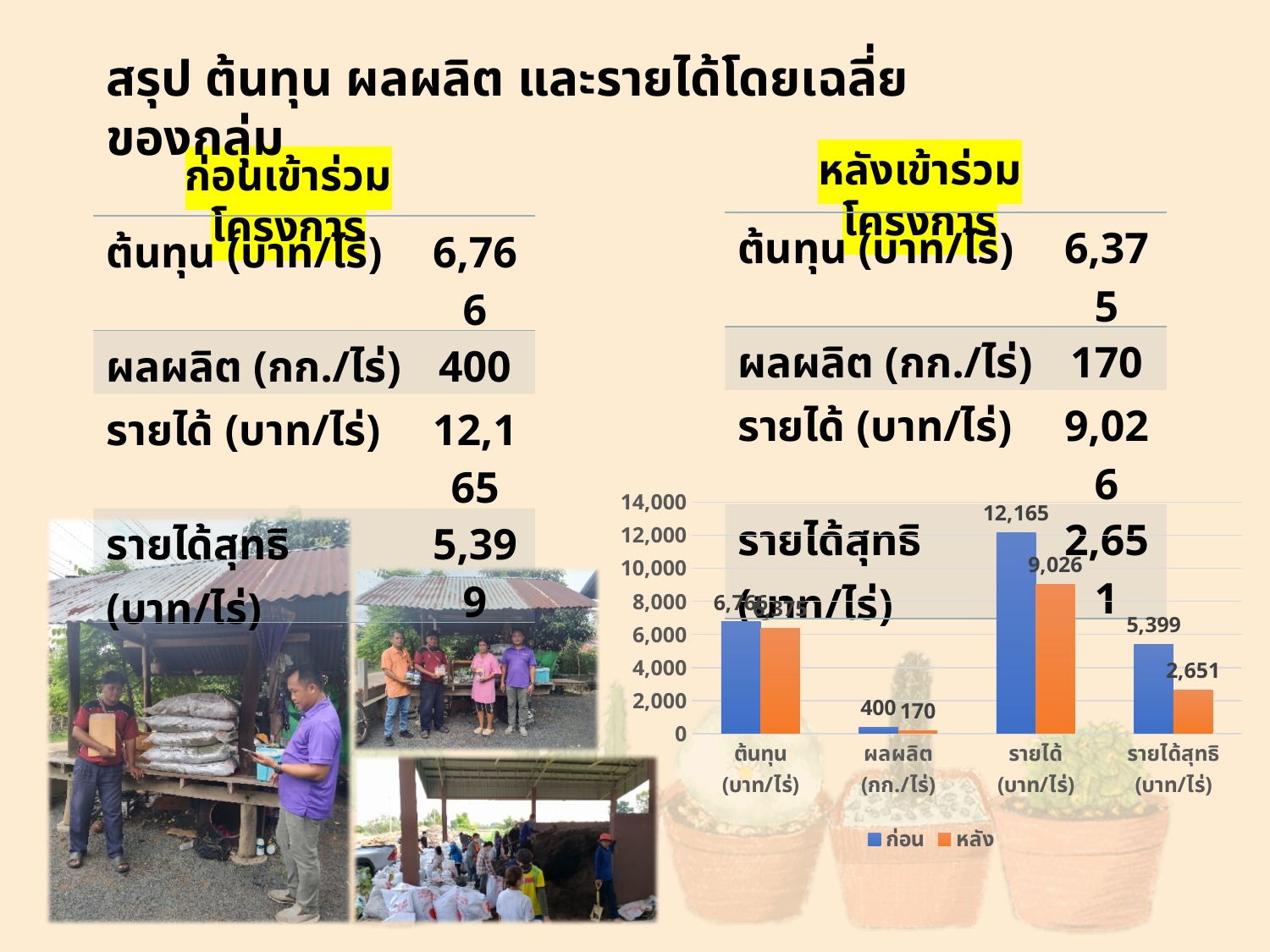
What is the value of ก่อน for รายได้ (บาท/ไร่) in the chart? 12,165 What is the difference between the ก่อน and หลัง values for รายได้ (บาท/ไร่) in the chart? 3,139 How many series does the chart legend list? 2 What is the value of หลัง for รายได้สุทธิ (บาท/ไร่) in the chart? 2,651 What is the value of ก่อน for ผลผลิต (กก./ไร่) in the chart? 400 Which category has the lowest หลัง value in the chart? ผลผลิต (กก./ไร่) What is the value of หลัง for รายได้ (บาท/ไร่) in the chart? 9,026 Which category has the highest ก่อน value in the chart? รายได้ (บาท/ไร่) Is the ก่อน value for ต้นทุน (บาท/ไร่) greater or less than 6,000? greater What kind of chart is shown on the slide? bar chart How many categories are shown on the x axis of the chart? 4 For รายได้สุทธิ (บาท/ไร่), which series has the larger value, ก่อน or หลัง? ก่อน